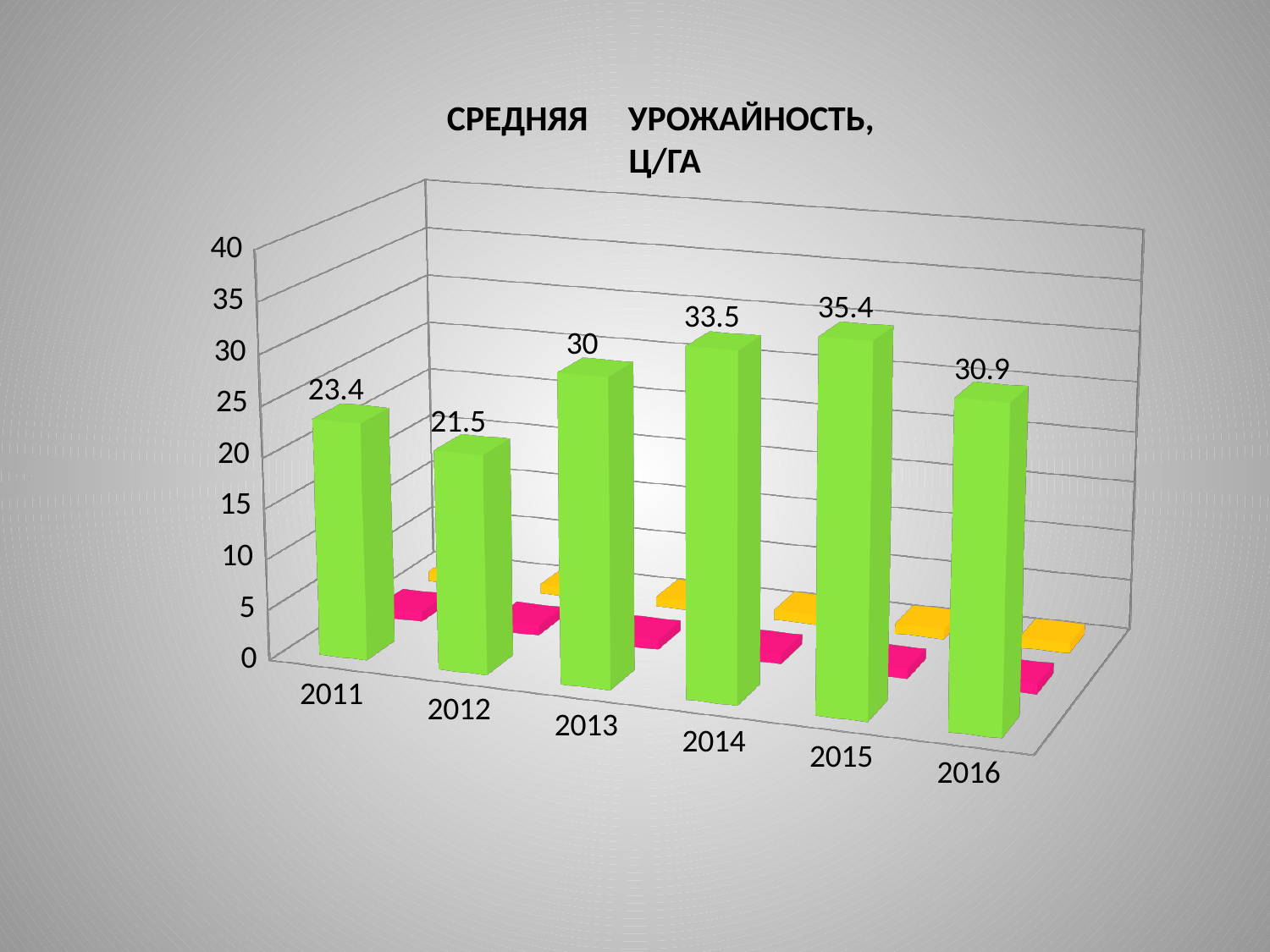
What kind of chart is shown on the slide? bar chart How many years are shown on the x axis? 6 Which is larger, the value for 2013 or the value for 2016? 2016 Which year has the highest labelled value? 2015 What is the value shown for 2016? 30.9 What is the difference between the values for 2015 and 2014? 1.9 Which year has the lowest labelled value? 2012 Do the labelled values rise or fall from 2012 to 2015? rise What is the difference between the values for 2013 and 2012? 8.5 What is the average yield value shown for 2011? 23.4 Is the value for 2011 greater or less than 25? less What value is labelled on the green bar for 2014? 33.5